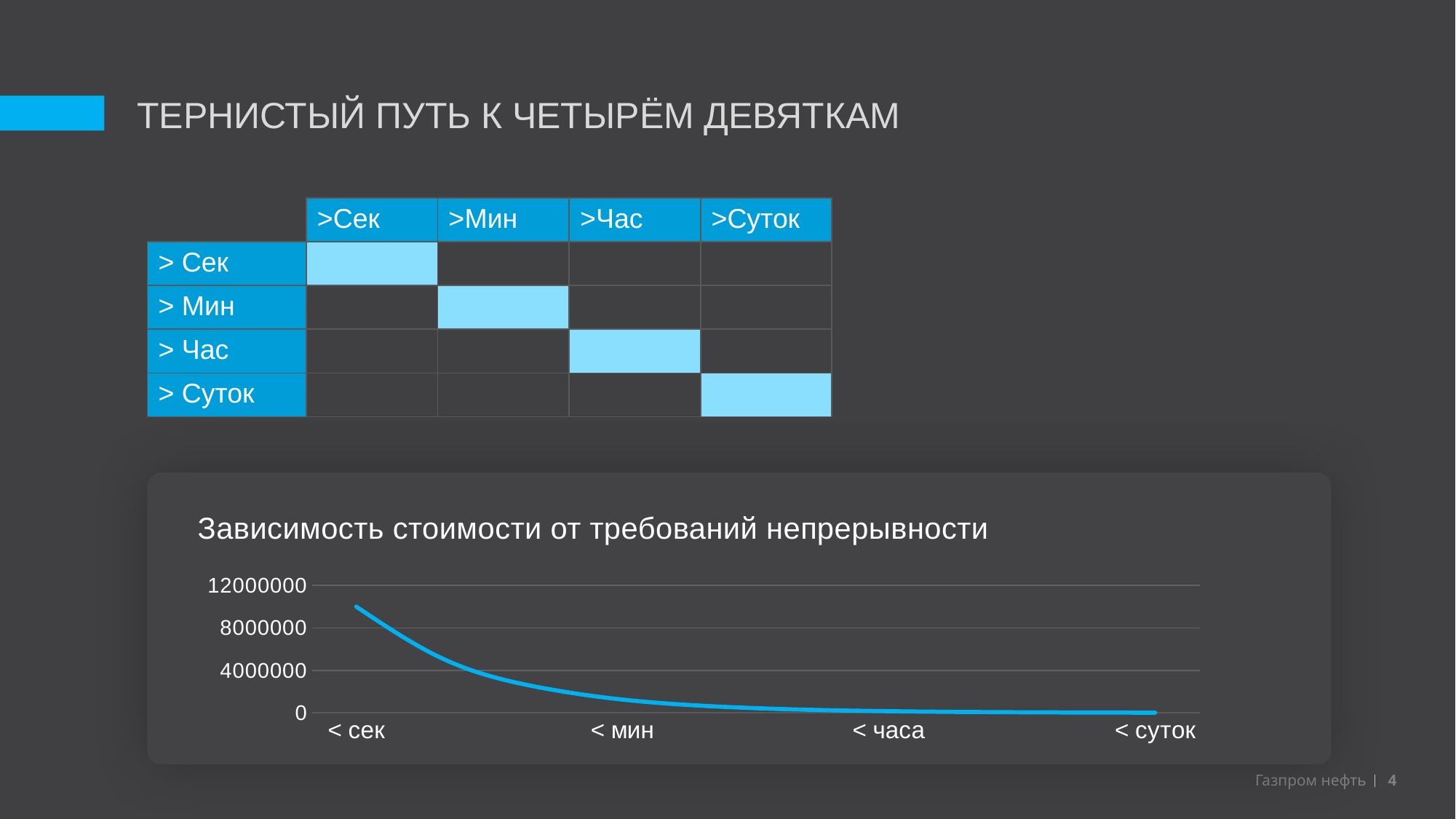
Is the value for "< мин" greater or less than 4000000? less Which category has the highest value in the chart? < сек Is the value for "< сек" greater or less than 12000000? less What is the highest tick value shown on the y axis of the chart? 12000000 What kind of chart is shown under the title "Зависимость стоимости от требований непрерывности"? line chart Is the value for "< часа" greater or less than 4000000? less How many categories are shown on the x axis of the chart? 4 What is the title of the chart on the slide? Зависимость стоимости от требований непрерывности Which is larger, the value for "< мин" or the value for "< суток"? < мин Which is larger, the value for "< сек" or the value for "< мин"? < сек Do the values in the chart rise or fall from "< сек" to "< суток"? fall